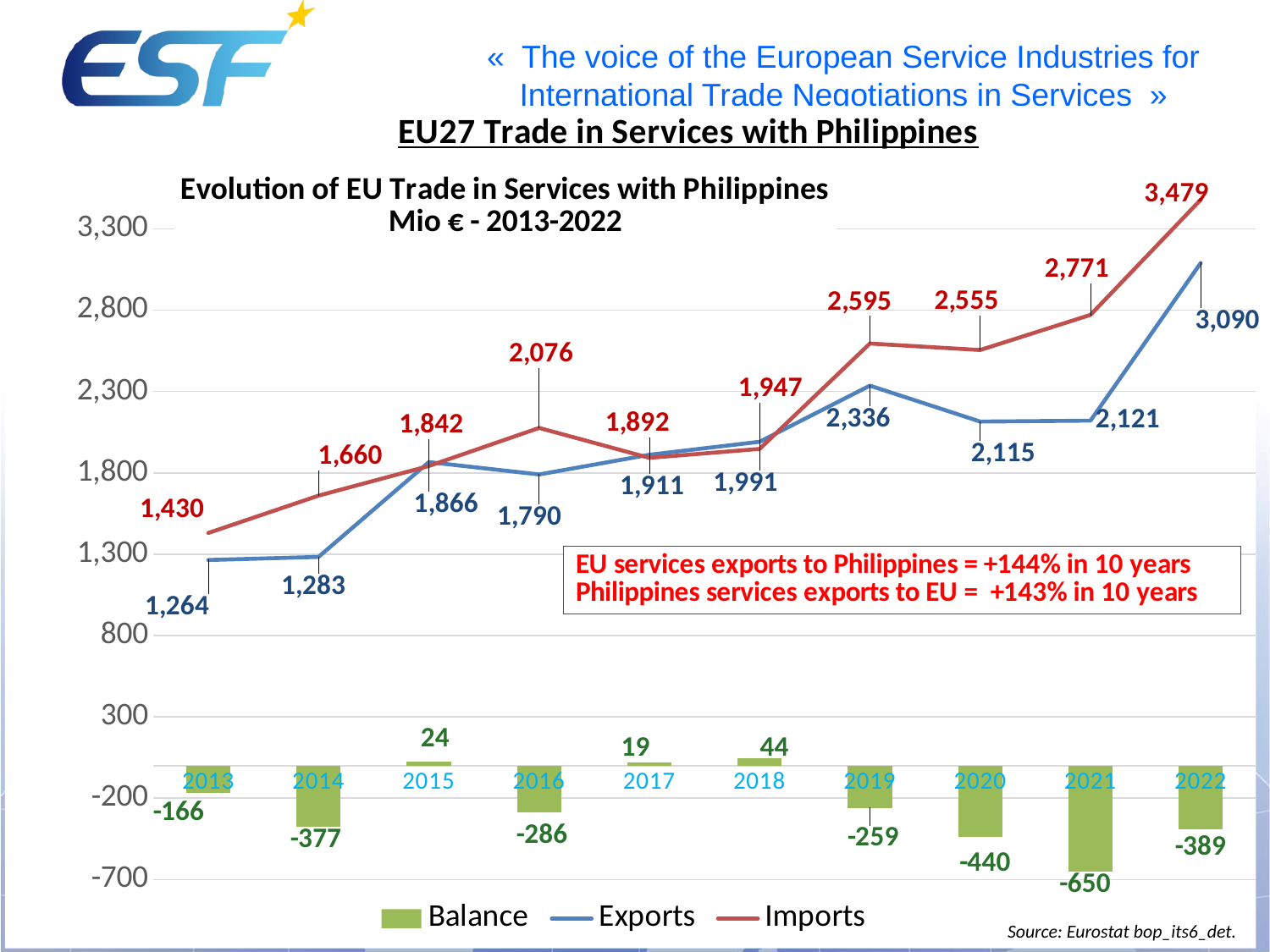
What is the value of Exports in 2022? 3,090 What is the difference between Imports and Exports in 2022? 389 How many series does the legend list? 3 In which year is the Balance lowest? 2021 Do Imports rise or fall overall from 2013 to 2022? Rise In 2015, which is larger: Exports or Imports? Exports How many years are shown on the x axis? 10 In which year are Imports highest? 2022 What is the Balance value for 2021? -650 What is the value of Imports in 2016? 2,076 What is the title of the chart? Evolution of EU Trade in Services with Philippines Mio € - 2013-2022 What kind of chart is this? Combined line and bar chart